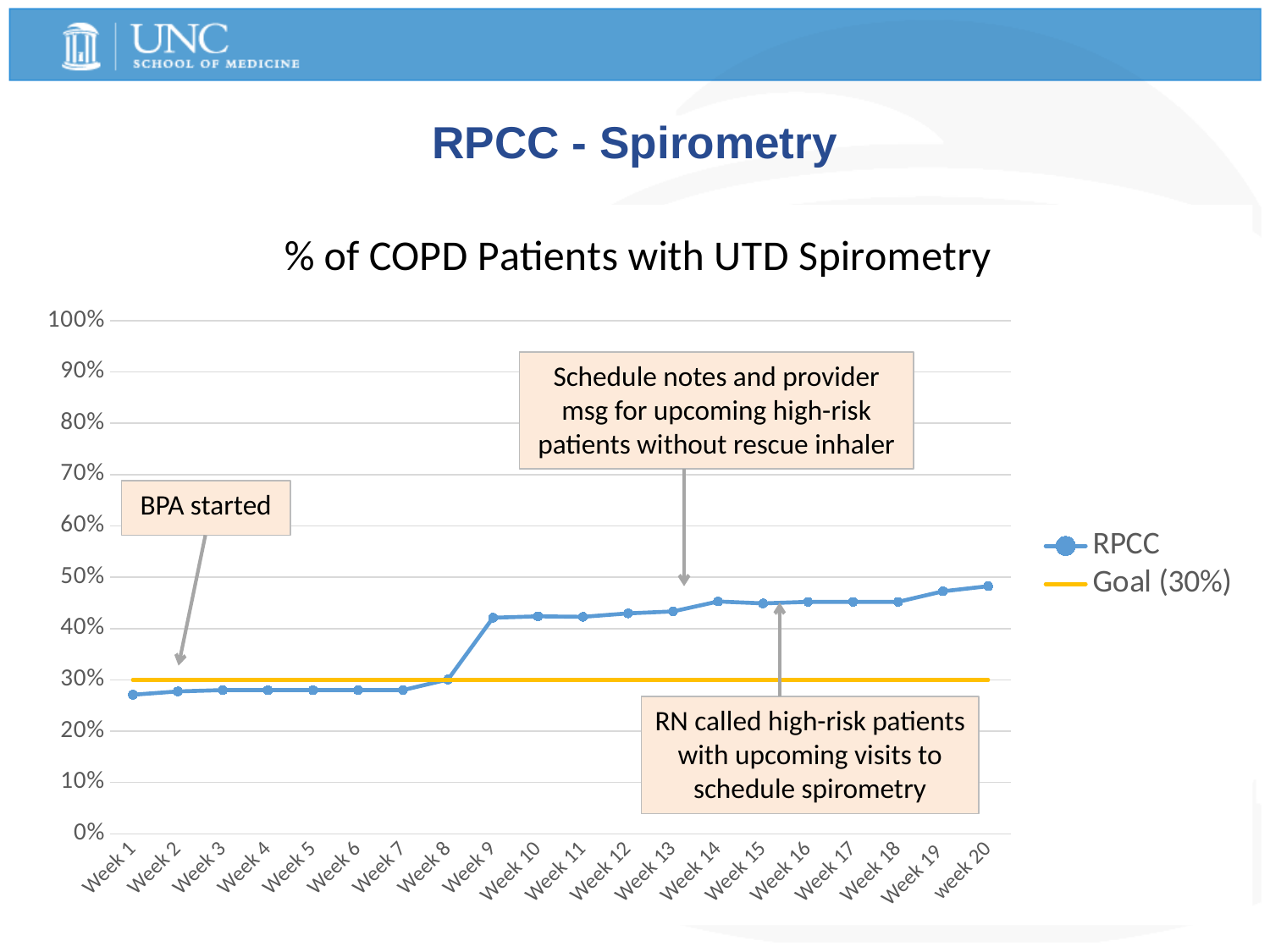
Is the RPCC value for Week 9 greater or less than 40%? greater Is the RPCC value for Week 20 greater or less than 50%? less How many series does the legend list? 2 What does the annotation pointing at Week 1 say? BPA started What kind of chart is shown on the slide? line chart Do the RPCC values generally rise or fall from Week 1 to week 20? rise Which is larger, the RPCC value for Week 9 or for Week 7? Week 9 Is the RPCC value for Week 1 greater or less than 30%? less Which week has the highest RPCC value? week 20 What is the value of the Goal line? 30% What is the title of the chart? % of COPD Patients with UTD Spirometry How many weeks are plotted along the x axis? 20